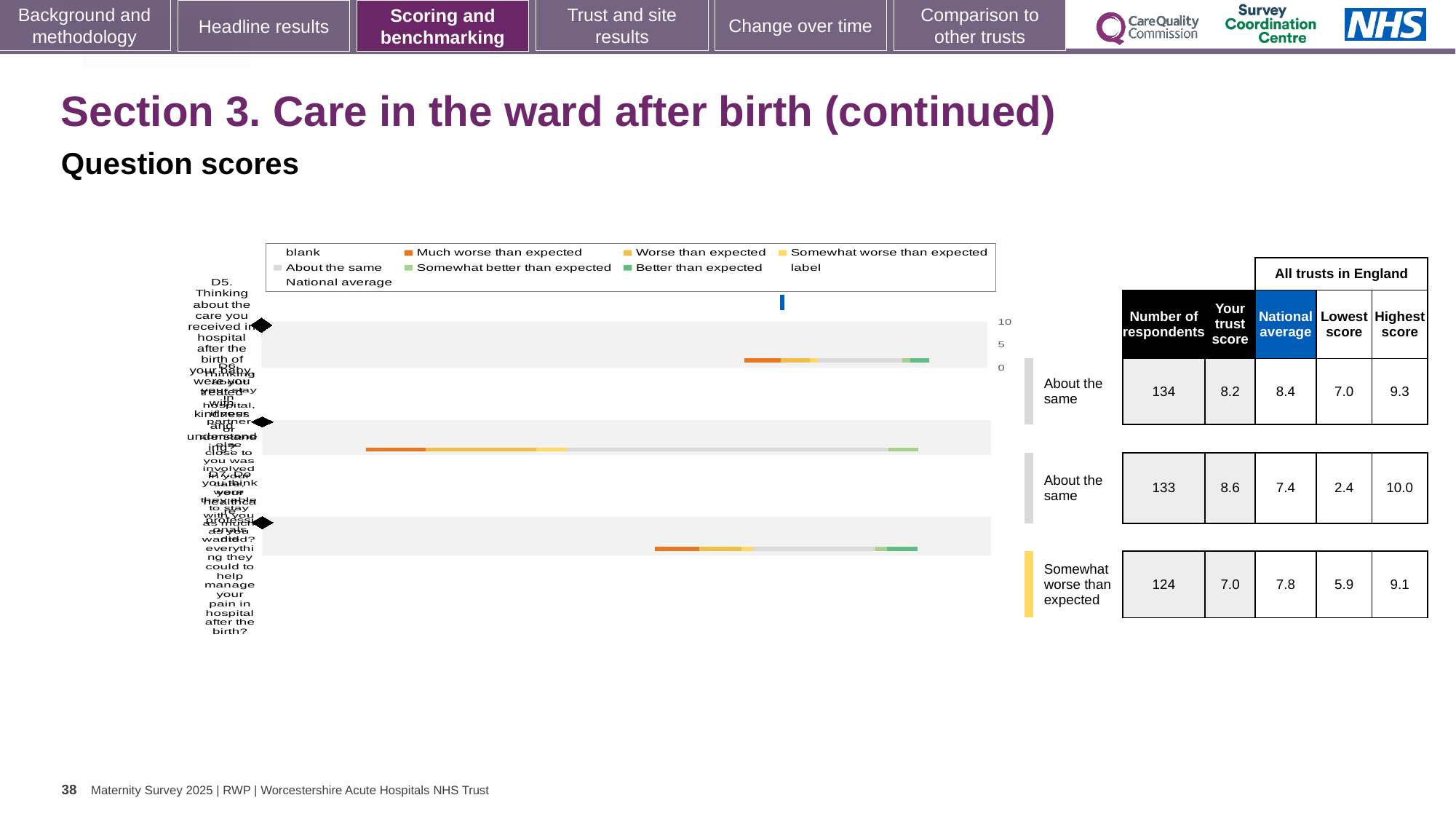
How many entries does the chart legend list? 9 In the table beside the chart, what is the difference between the national average and the trust score for the bottom row? 0.8 What kind of chart is shown on the slide? bar chart What does the blue marker in the legend represent? National average In the table beside the chart, what is 'Your trust score' for the middle row? 8.6 In the table beside the chart, what is the smallest 'Lowest score' value shown? 2.4 In the table beside the chart, which row has the highest 'Highest score' value? the middle row (10.0) In the table beside the chart, how many respondents are shown for the top row? 134 How many question rows are plotted in the chart? 3 In the table beside the chart, what is the national average for the bottom row (rated 'Somewhat worse than expected')? 7.8 What colour does the legend use for 'Much worse than expected'? orange In the table beside the chart, for the top row, which is larger: the trust score or the national average? the national average (8.4)